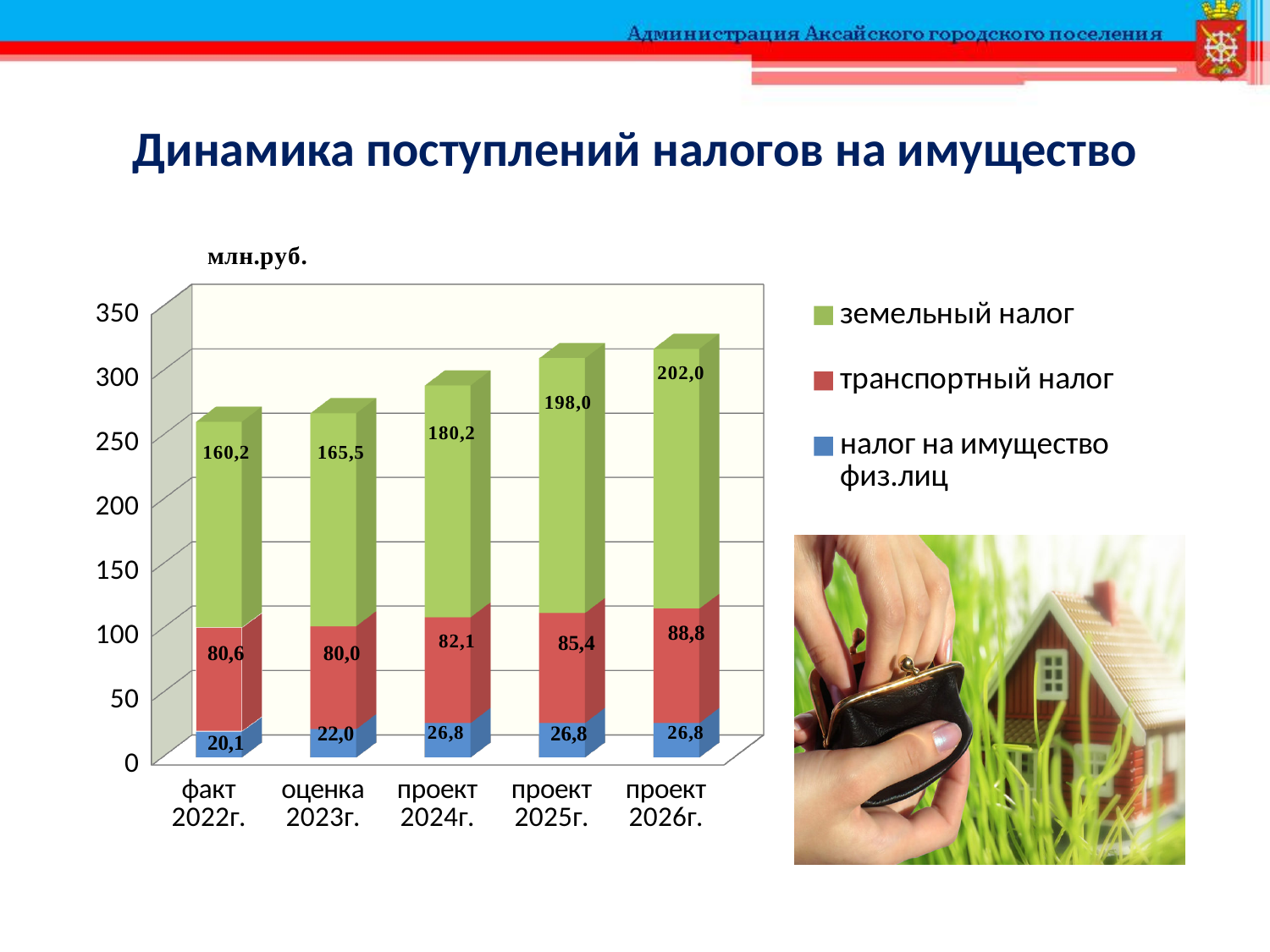
What is the value of налог на имущество физ.лиц for оценка 2023г.? 22,0 What is the value of транспортный налог for факт 2022г.? 80,6 How many categories are shown on the x axis? 5 What is the value of земельный налог for проект 2025г.? 198,0 Which is larger: транспортный налог for проект 2024г. or for оценка 2023г.? проект 2024г. What is the difference between земельный налог for проект 2026г. and факт 2022г.? 41,8 How many series does the legend list? 3 What kind of chart is shown on the slide? stacked bar chart In which category is налог на имущество физ.лиц the lowest? факт 2022г. In which category is земельный налог the highest? проект 2026г. What is the total of the stacked bar for проект 2026г.? 317,6 Does земельный налог rise or fall from факт 2022г. to проект 2026г.? rise